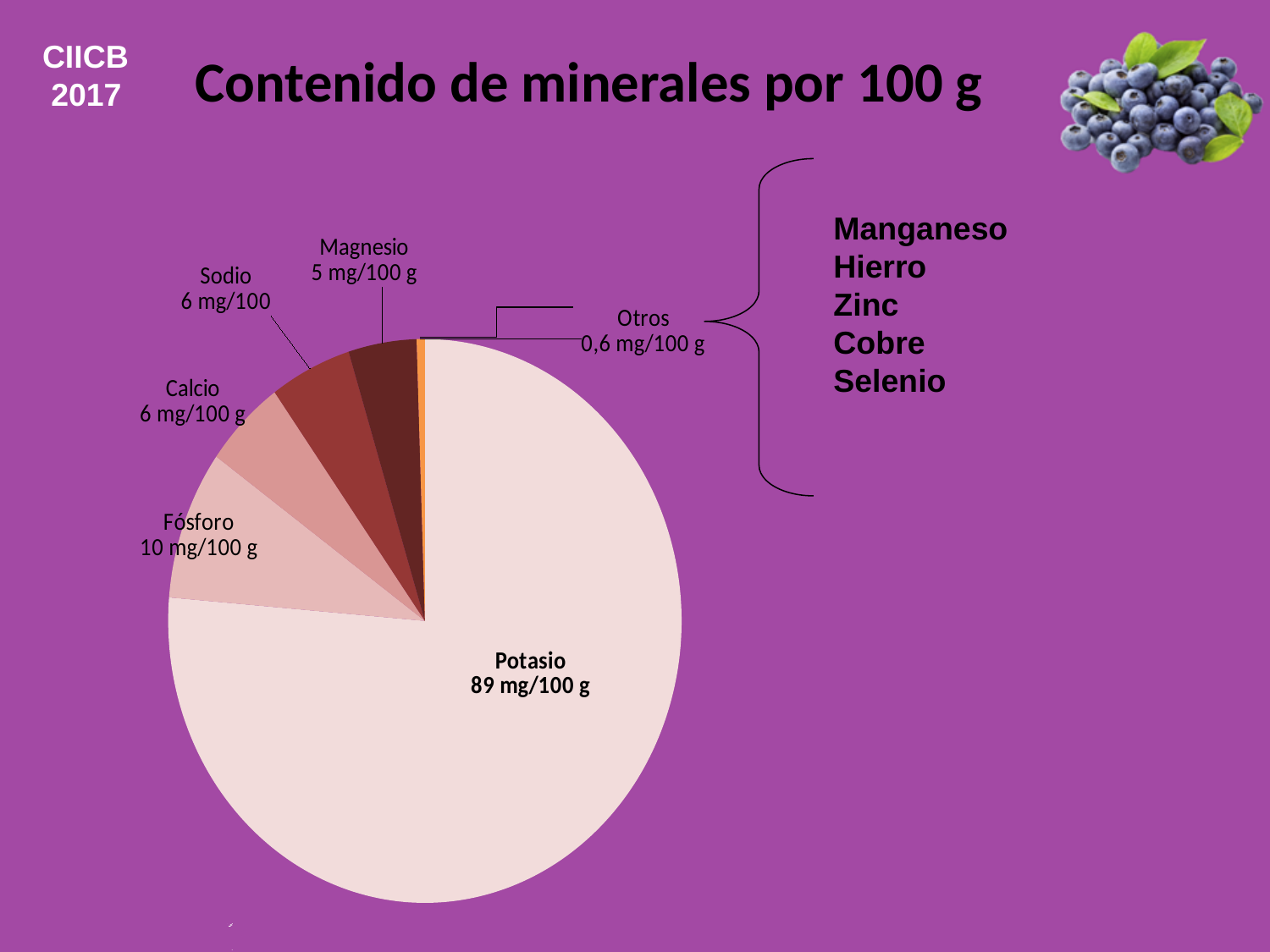
What kind of chart is shown on the slide? Pie chart What is the difference between the values for Potasio and Fósforo? 79 mg/100 g What is the value shown for Fósforo? 10 mg/100 g What is the title of the chart? Contenido de minerales por 100 g Which minerals are grouped under the Otros slice? Manganeso, Hierro, Zinc, Cobre, Selenio How many slices does the pie chart have? 6 What is the value shown for Otros? 0,6 mg/100 g What is the value shown for Potasio? 89 mg/100 g Which slice of the pie has the smallest value? Otros What is the value shown for Magnesio? 5 mg/100 g Which has a larger value, Fósforo or Magnesio? Fósforo Which mineral has the largest slice of the pie? Potasio